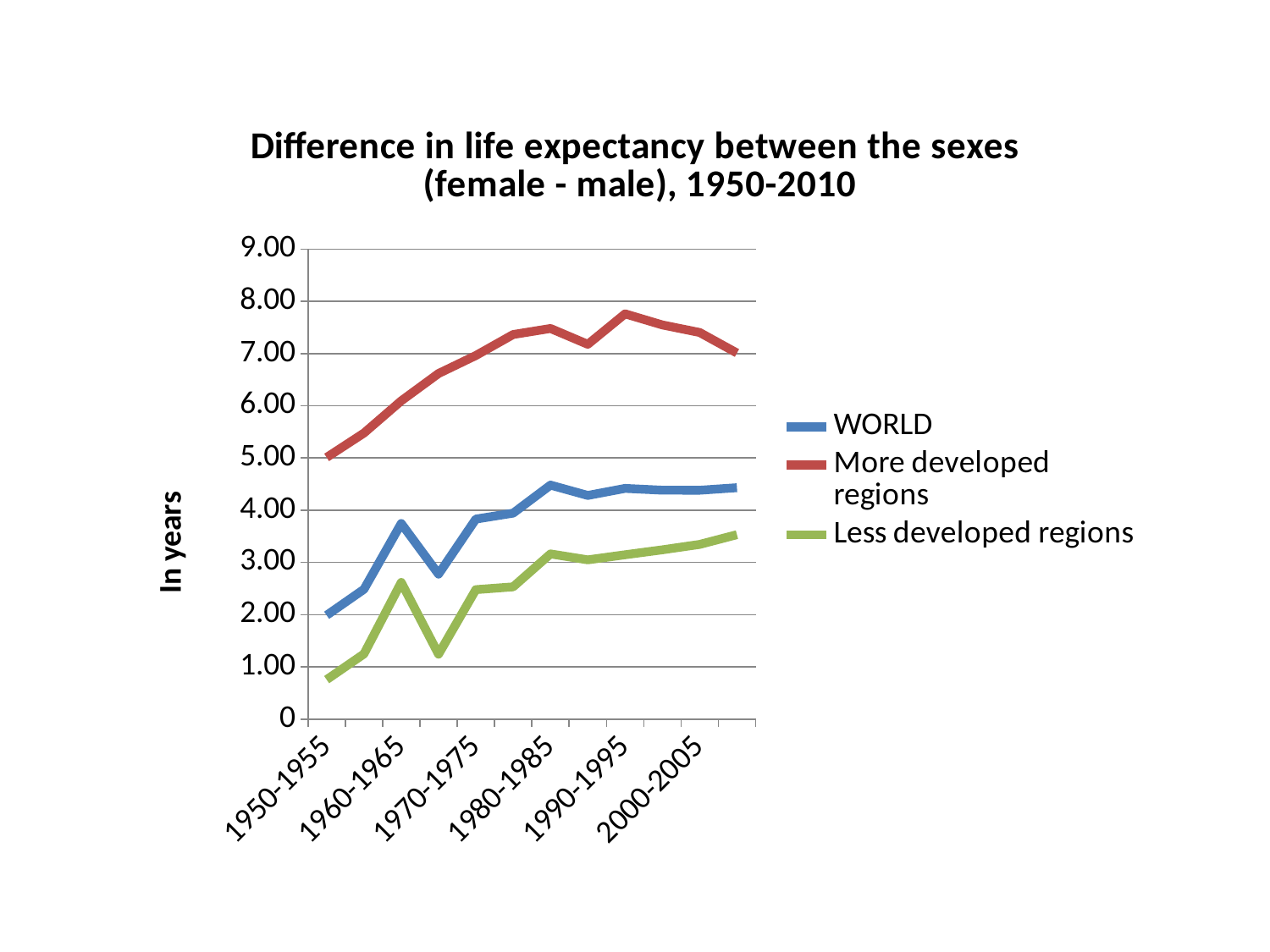
Is the value for More developed regions in 1990-1995 greater or less than 7.00? greater Is the value for WORLD in 2000-2005 greater or less than 4.00? greater Is the value for Less developed regions in 1950-1955 greater or less than 1.00? less What is the title of the vertical axis? In years Which series has the highest values across the whole period? More developed regions Does the Less developed regions series generally rise or fall from 1950-1955 to the end of the period? rise What kind of chart is shown on the slide? line chart What colour is the line for the WORLD series? blue In 1980-1985, which is larger: the value for WORLD or the value for More developed regions? More developed regions How many series does the legend list? 3 Which series has the lowest values across the whole period? Less developed regions